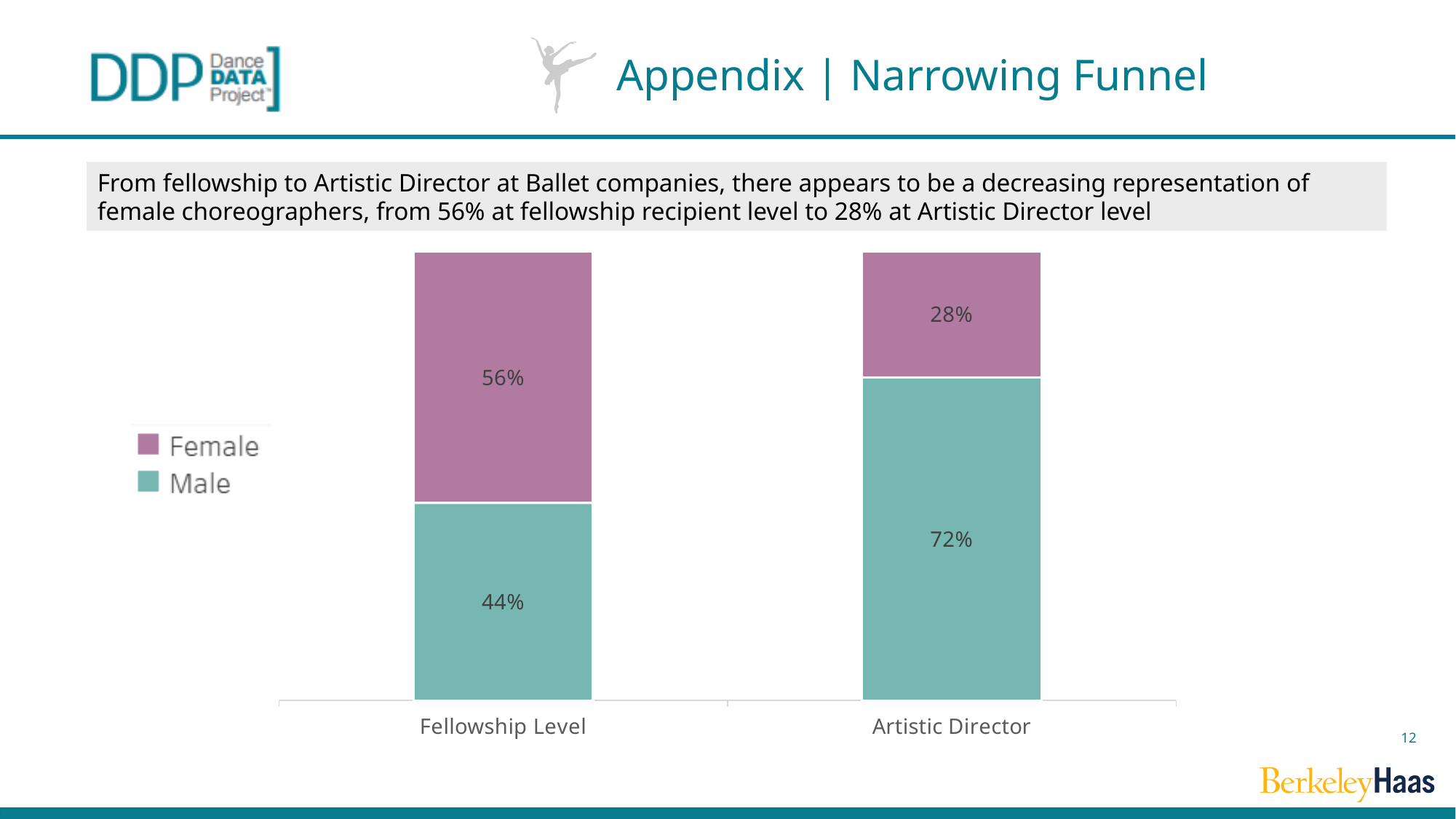
Is the Male share larger at Fellowship Level or at Artistic Director level? Artistic Director Which category has the lower Male share? Fellowship Level What is the Female share at Fellowship Level? 56% How many categories are shown on the x axis? 2 What is the Male share at Fellowship Level? 44% What kind of chart is shown on the slide? Stacked bar chart What is the Female share at Artistic Director level? 28% What is the difference between the Female share at Fellowship Level and at Artistic Director level? 28% What is the Male share at Artistic Director level? 72% Which colour represents Female in the legend? Purple Which category has the higher Female share? Fellowship Level How many series does the legend list? 2